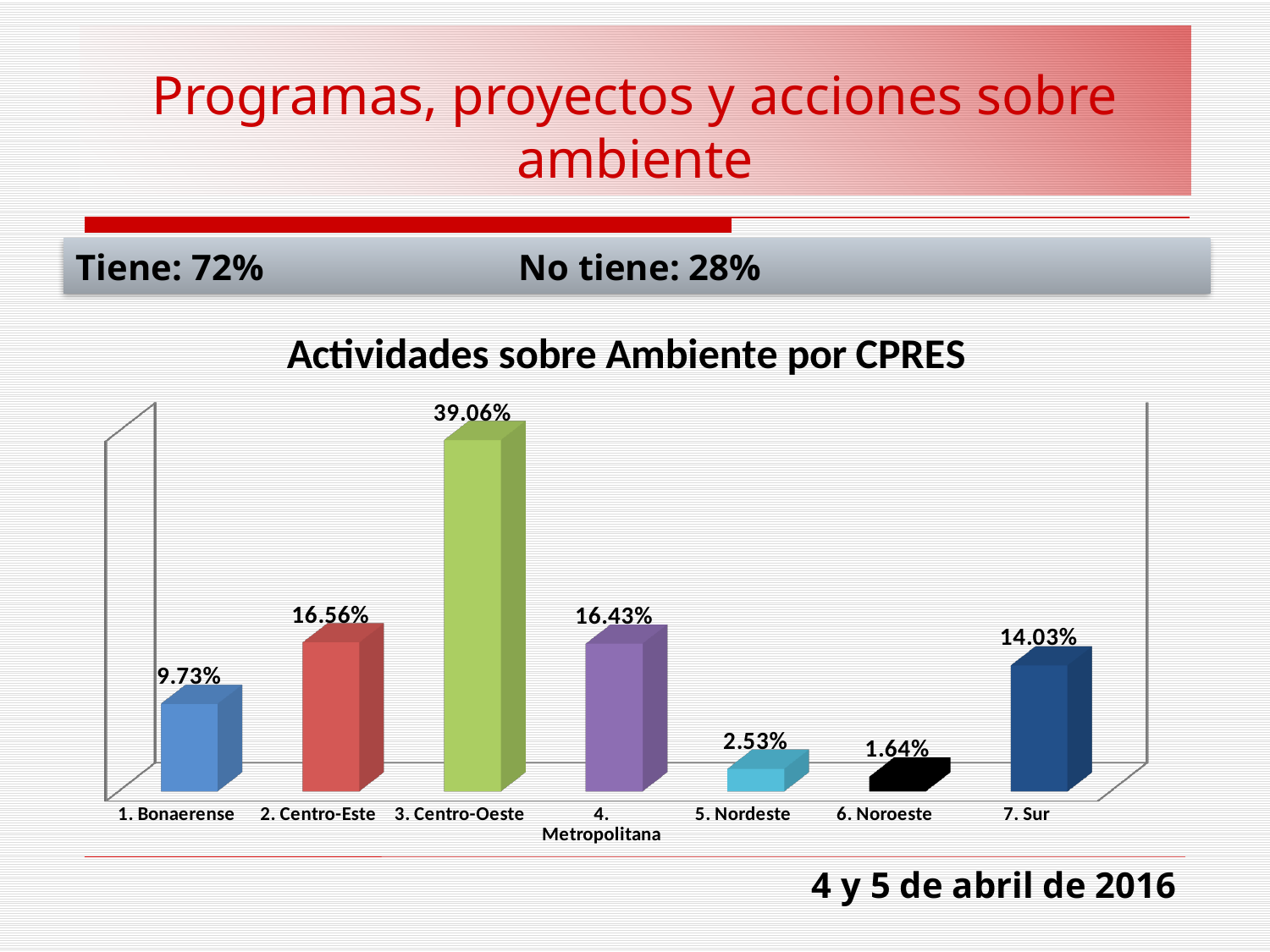
Which category has the lowest value? 6. Noroeste What is the value for 5. Nordeste? 2.53% What is the value for 1. Bonaerense? 9.73% What is the value for 7. Sur? 14.03% What kind of chart is shown on the slide? Bar chart What is the title of the chart? Actividades sobre Ambiente por CPRES How many categories are shown in the chart? 7 Which category has the highest value? 3. Centro-Oeste What is the difference between the values for 7. Sur and 6. Noroeste? 12.39% Which is larger, the value for 1. Bonaerense or the value for 7. Sur? 7. Sur What is the value for 3. Centro-Oeste in the chart? 39.06% What is the difference between the values for 3. Centro-Oeste and 2. Centro-Este? 22.50%